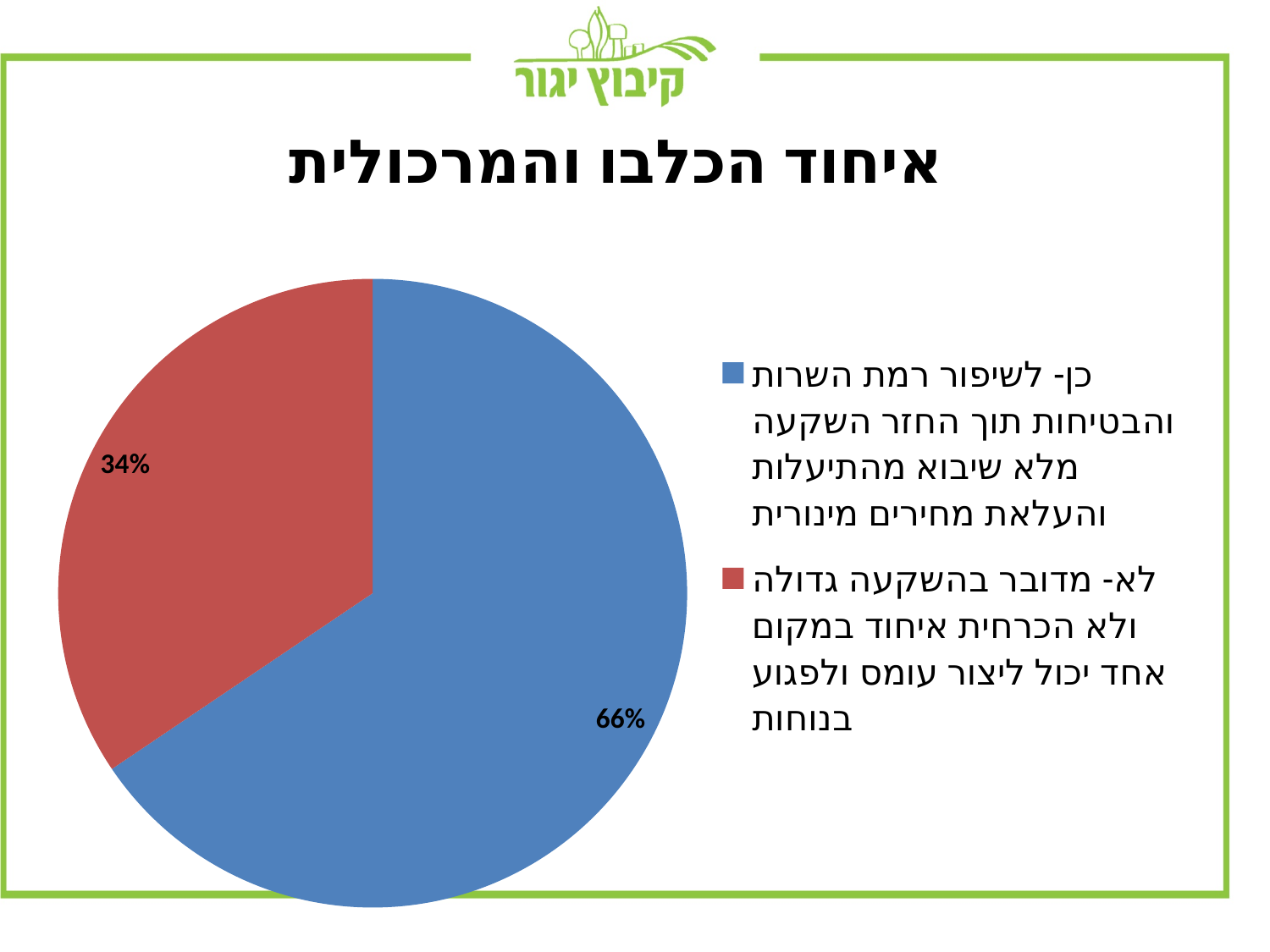
What percentage is shown for the blue slice (the legend entry beginning with "כן")? 66% What share of the pie does the "לא" slice represent? 34% What is the difference in percentage points between the "כן" slice and the "לא" slice? 32 How many slices does the pie chart have? 2 What is the title of the chart on the slide? איחוד הכלבו והמרכולית Which is larger, the "כן" slice or the "לא" slice? the "כן" slice What kind of chart is shown on the slide? pie chart What colour is the slice representing the "כן" response? blue Which slice is the smallest in the pie chart? the red "לא" slice (34%) How many entries does the legend list? 2 What percentage is shown for the red slice (the legend entry beginning with "לא")? 34% Which slice is the largest in the pie chart? the blue "כן" slice (66%)